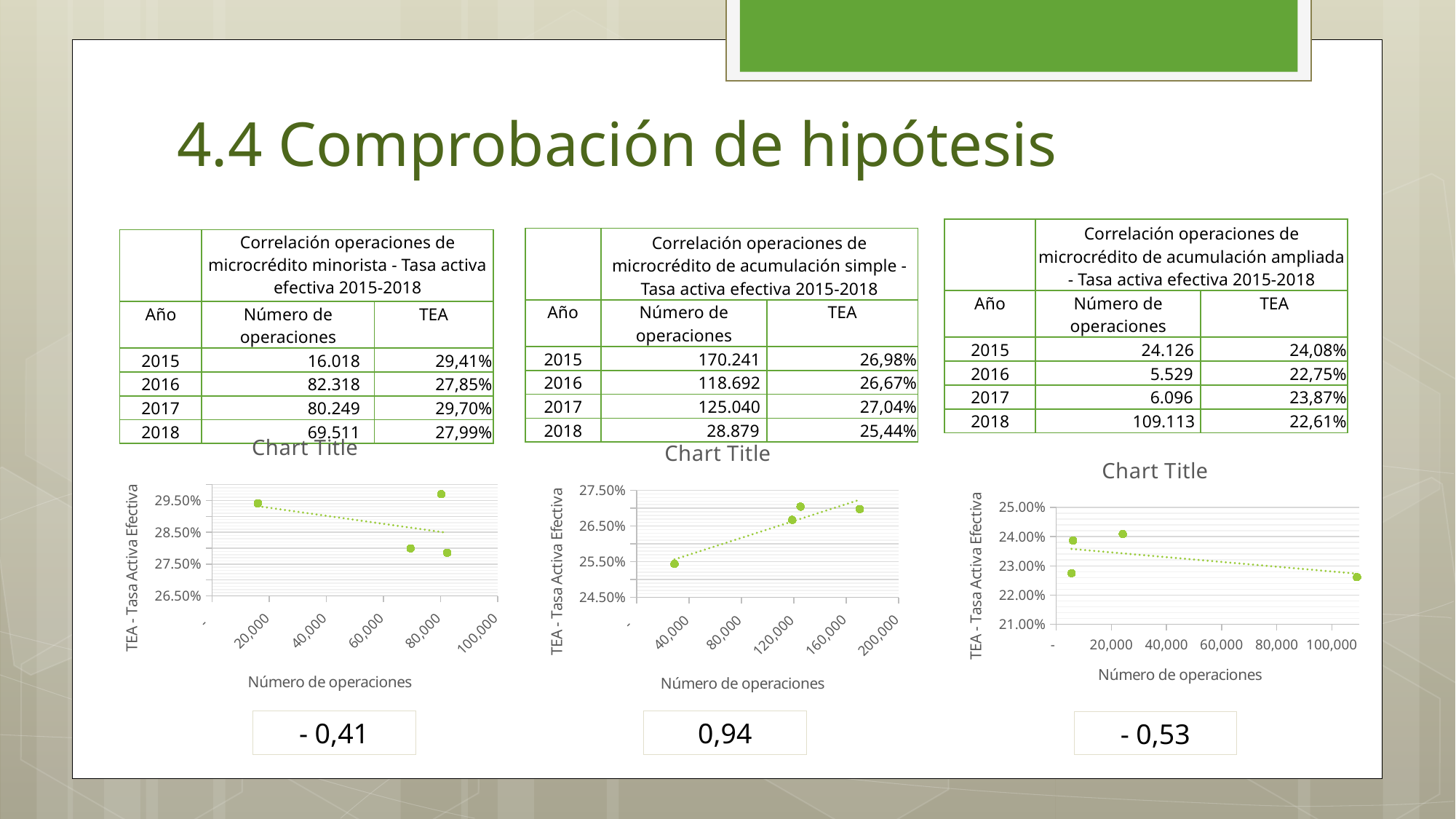
How many data points are plotted in the middle chart? 4 In the right chart, does the dotted trend line rise or fall as the number of operations increases? fall What is the vertical axis title of the left chart? TEA - Tasa Activa Efectiva In the left chart, does the dotted trend line rise or fall as the number of operations increases? fall What correlation value is shown in the box below the middle chart? 0,94 In the middle chart, is the TEA value of the rightmost point (near 180,000 operations) greater or less than 26.50%? greater How many data points are plotted in the left chart? 4 In the left chart, is the TEA value of the leftmost point (near 20,000 operations) greater or less than 28.50%? greater In the middle chart, is the TEA value of the leftmost point (near 40,000 operations) greater or less than 26.50%? less In the middle chart, does the dotted trend line rise or fall as the number of operations increases? rise What kind of chart is the left chart on the slide? scatter chart